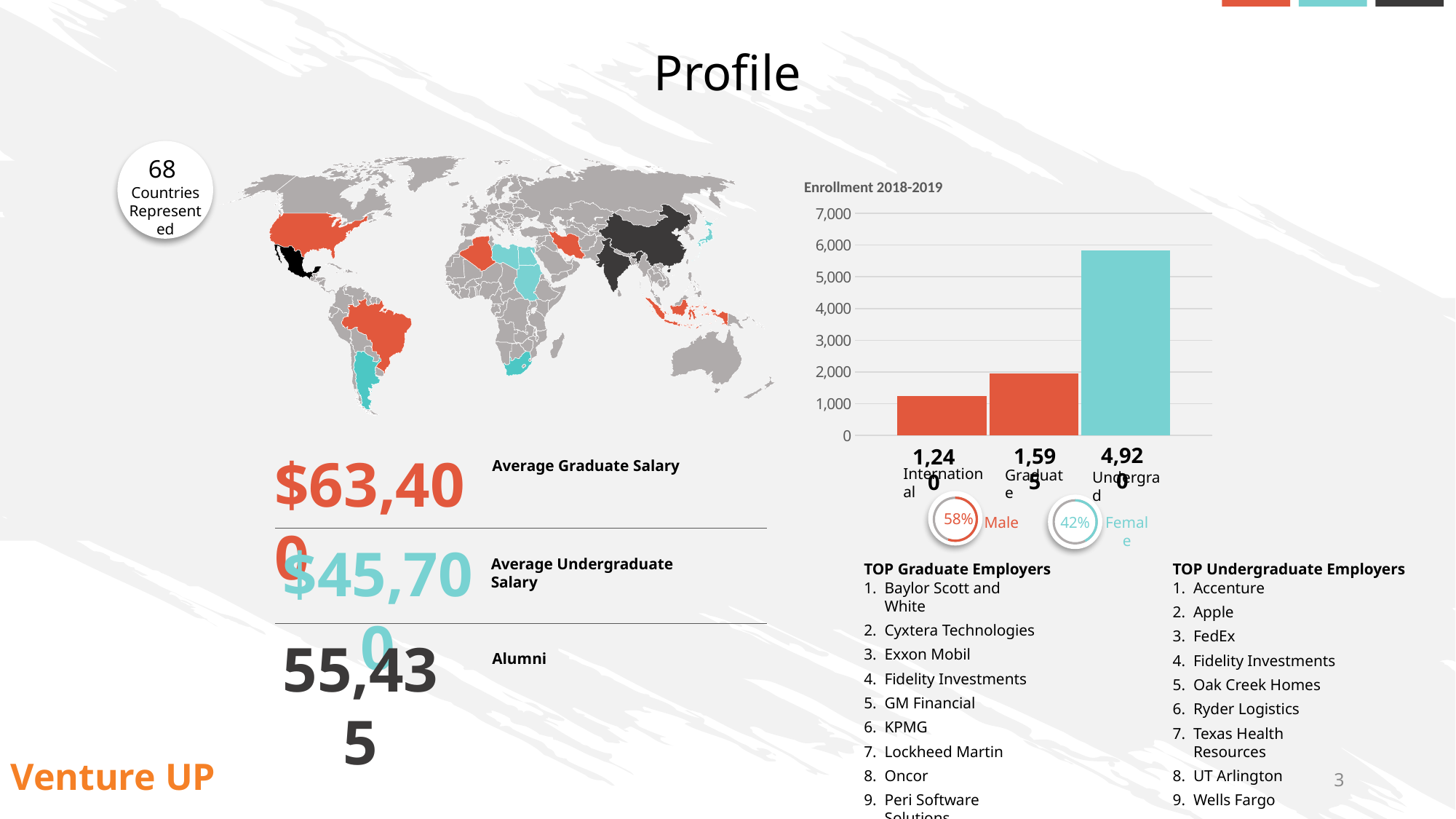
In the Enrollment 2018-2019 chart, is the Undergraduate bar greater or less than 5,000? greater In the Enrollment 2018-2019 chart, which category has the lowest enrollment? International In the Enrollment 2018-2019 chart, what value is printed for Graduate? 1,595 How many categories are shown in the Enrollment 2018-2019 bar chart? 3 In the Enrollment 2018-2019 chart, what value is printed for Undergraduate? 4,920 In the Enrollment 2018-2019 chart, is the Graduate bar greater or less than 3,000? less In the Enrollment 2018-2019 chart, what value is printed for International? 1,240 What is the title of the bar chart on the slide? Enrollment 2018-2019 What type of chart is the Enrollment 2018-2019 chart? bar chart In the Enrollment 2018-2019 chart, which is larger, Graduate or International? Graduate In the Enrollment 2018-2019 chart, which category has the highest enrollment? Undergraduate In the Male/Female donut charts below the bar chart, what share is Male? 58%